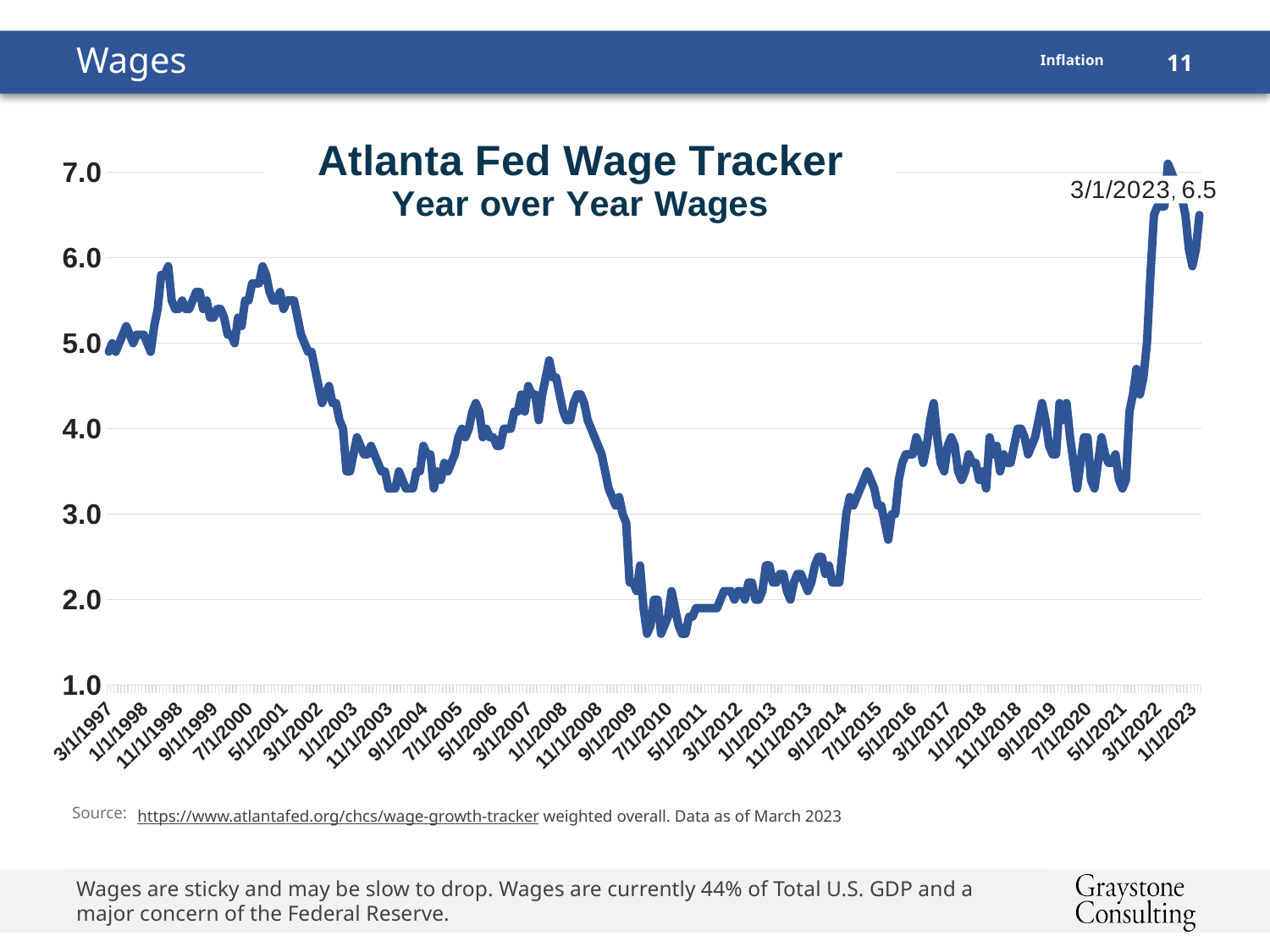
Does the line rise or fall between 3/1/2021 and 3/1/2022? rise Does the line rise or fall between 5/1/2001 and 11/1/2003? fall What is the value labelled on the chart for 3/1/2023? 6.5 What is the title of the chart? Atlanta Fed Wage Tracker Is the value at 1/1/2018 greater or less than 3.0? greater Is the value at 11/1/2003 greater or less than 4.0? less What kind of chart is shown on the slide? line chart Is the value at 9/1/2009 greater or less than 3.0? less What is the subtitle shown under the chart title? Year over Year Wages How many lines are plotted on the chart? 1 Which is larger, the value at 3/1/2023 or the value at 7/1/2010? 3/1/2023